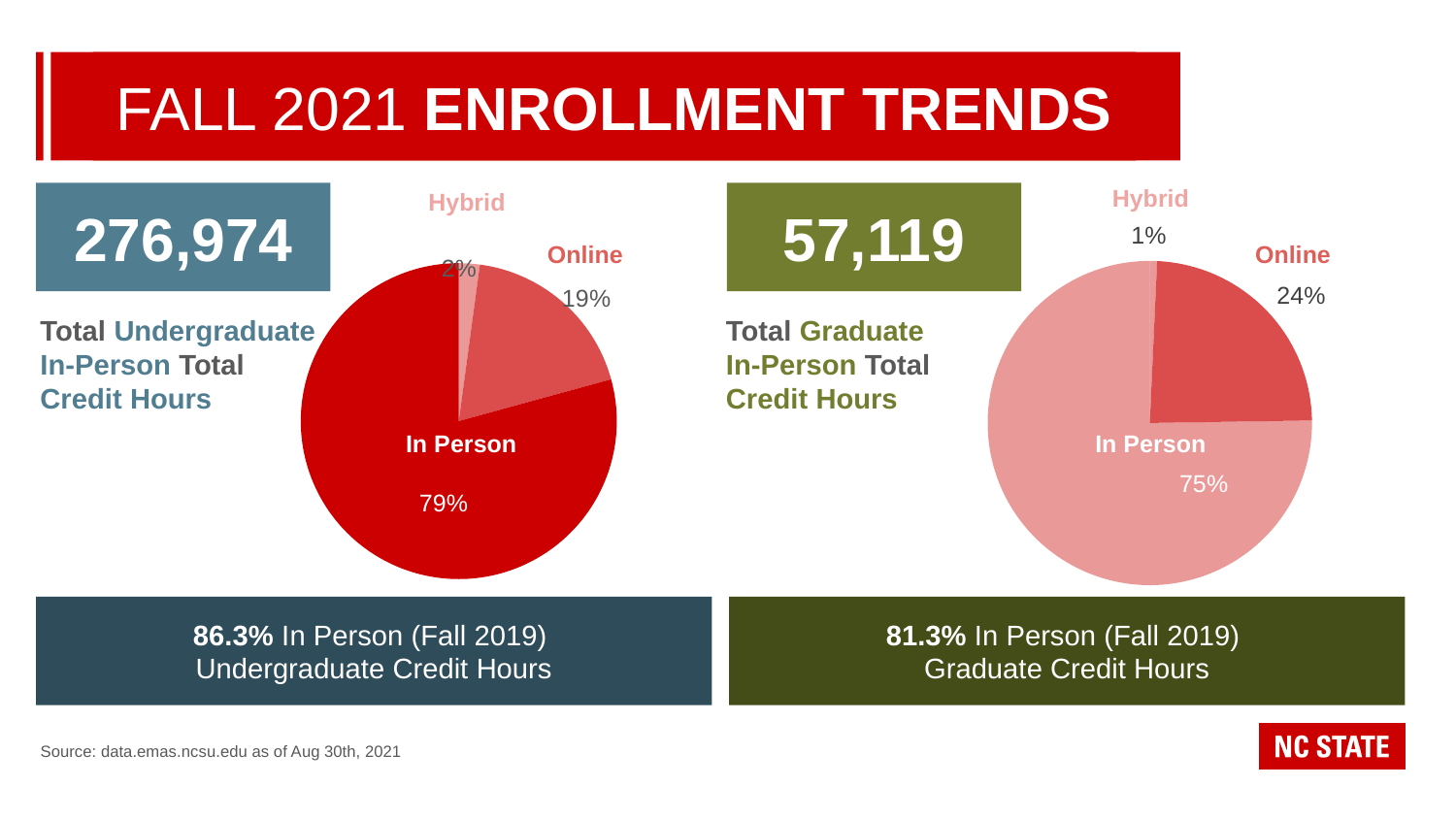
In the left (undergraduate) pie chart, what share of credit hours is Hybrid? 2% In the right (graduate) pie chart, what share of credit hours is In Person? 75% How many slices does the left (undergraduate) pie chart have? 3 In the left (undergraduate) pie chart, which category has the largest slice? In Person In the left (undergraduate) pie chart, what is the difference between the In Person and Online shares? 60% In the right (graduate) pie chart, what share of credit hours is Hybrid? 1% What kind of chart is used on the left side of the slide for undergraduate credit hours? Pie chart In the left (undergraduate) pie chart, what share of credit hours is Online? 19% In the left (undergraduate) pie chart, what share of credit hours is In Person? 79% In the right (graduate) pie chart, what share of credit hours is Online? 24% In the right (graduate) pie chart, which category has the smallest slice? Hybrid Which chart has the larger Online share, the left (undergraduate) pie or the right (graduate) pie? The right (graduate) pie